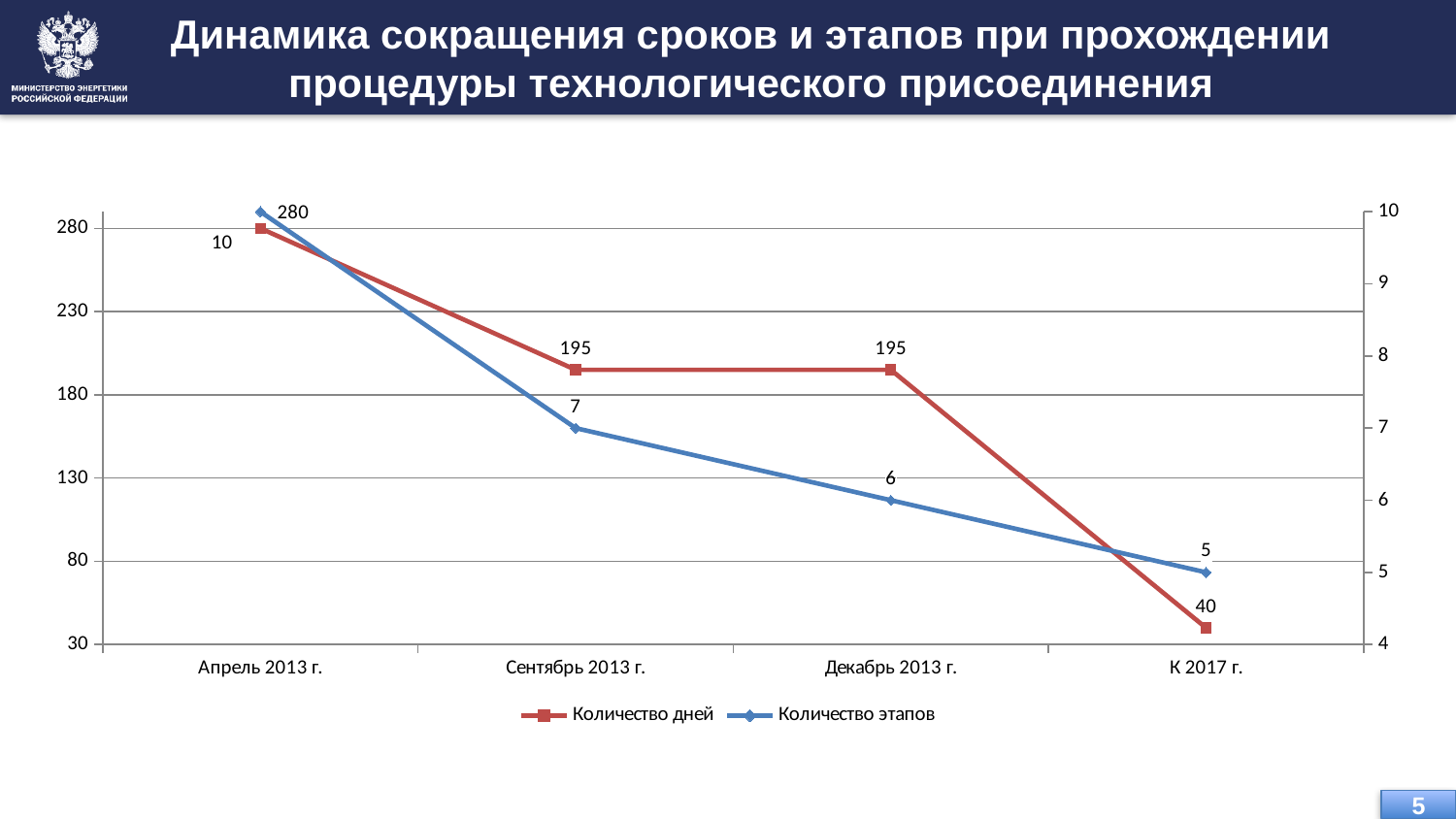
What is the value of Количество этапов for Апрель 2013 г.? 10 For which category is Количество дней lowest? К 2017 г. Does Количество этапов rise or fall from Апрель 2013 г. to К 2017 г.? fall What type of chart is shown on the slide? line chart What is the value of Количество дней for Апрель 2013 г.? 280 How many categories are shown on the x axis? 4 Which series is drawn in red? Количество дней What is the value of Количество дней for К 2017 г.? 40 What is the difference in Количество дней between Апрель 2013 г. and К 2017 г.? 240 How many series does the legend list? 2 What is the value of Количество дней for Сентябрь 2013 г.? 195 What is the value of Количество этапов for Декабрь 2013 г.? 6